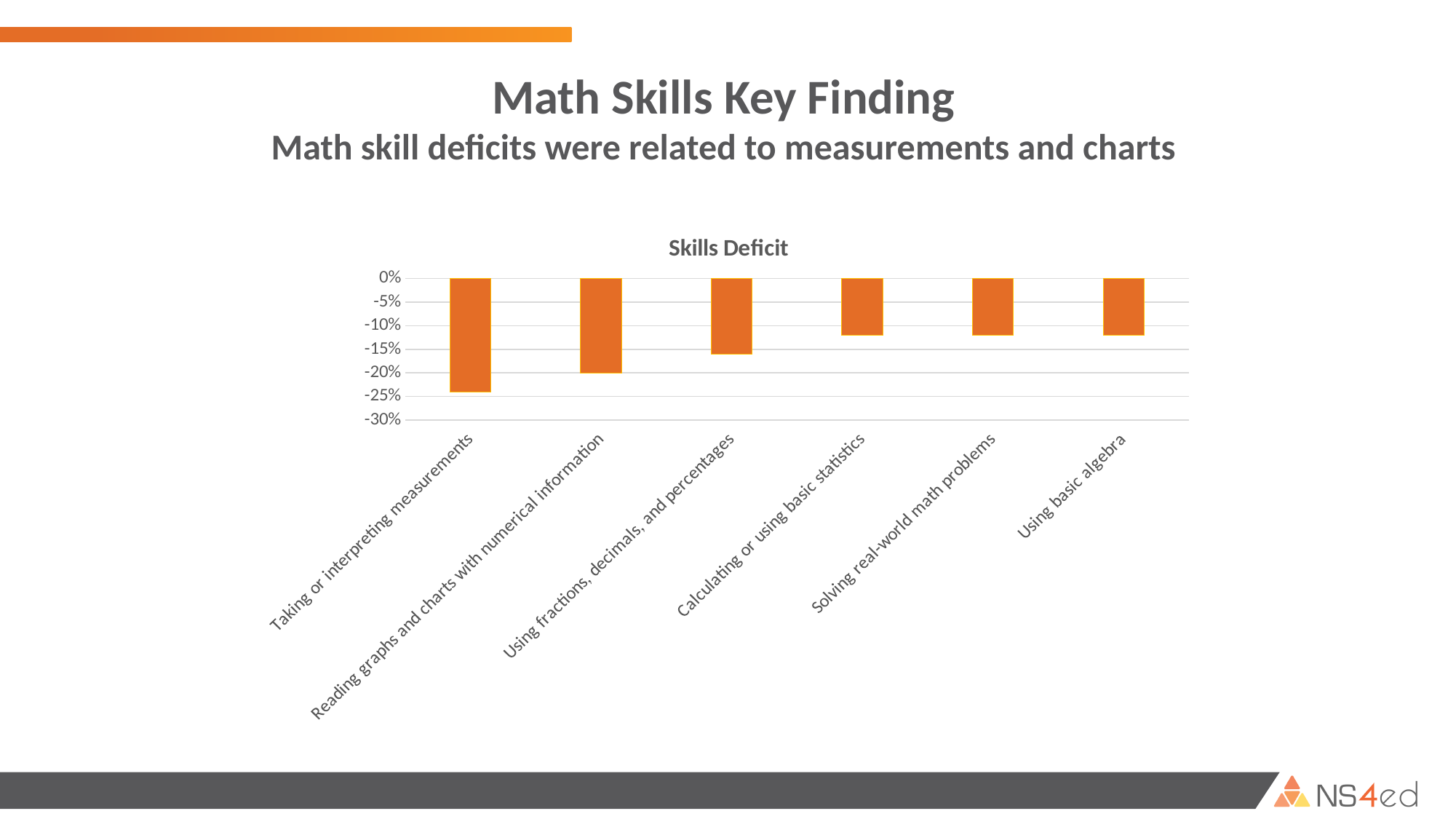
Is the value for Using fractions, decimals, and percentages greater or less than -20%? greater Is the value for Taking or interpreting measurements greater or less than -20%? less Is the value for Using basic algebra greater or less than -15%? greater What colour are the bars in the chart? orange What is the value for Reading graphs and charts with numerical information? -20% What kind of chart is shown on the slide? bar chart Which category has the lowest (most negative) value in the chart? Taking or interpreting measurements What is the title of the chart? Skills Deficit Do the bar values rise or fall moving from left to right along the x axis? rise Which bar extends further below zero: Taking or interpreting measurements or Using basic algebra? Taking or interpreting measurements How many categories are plotted in the chart? 6